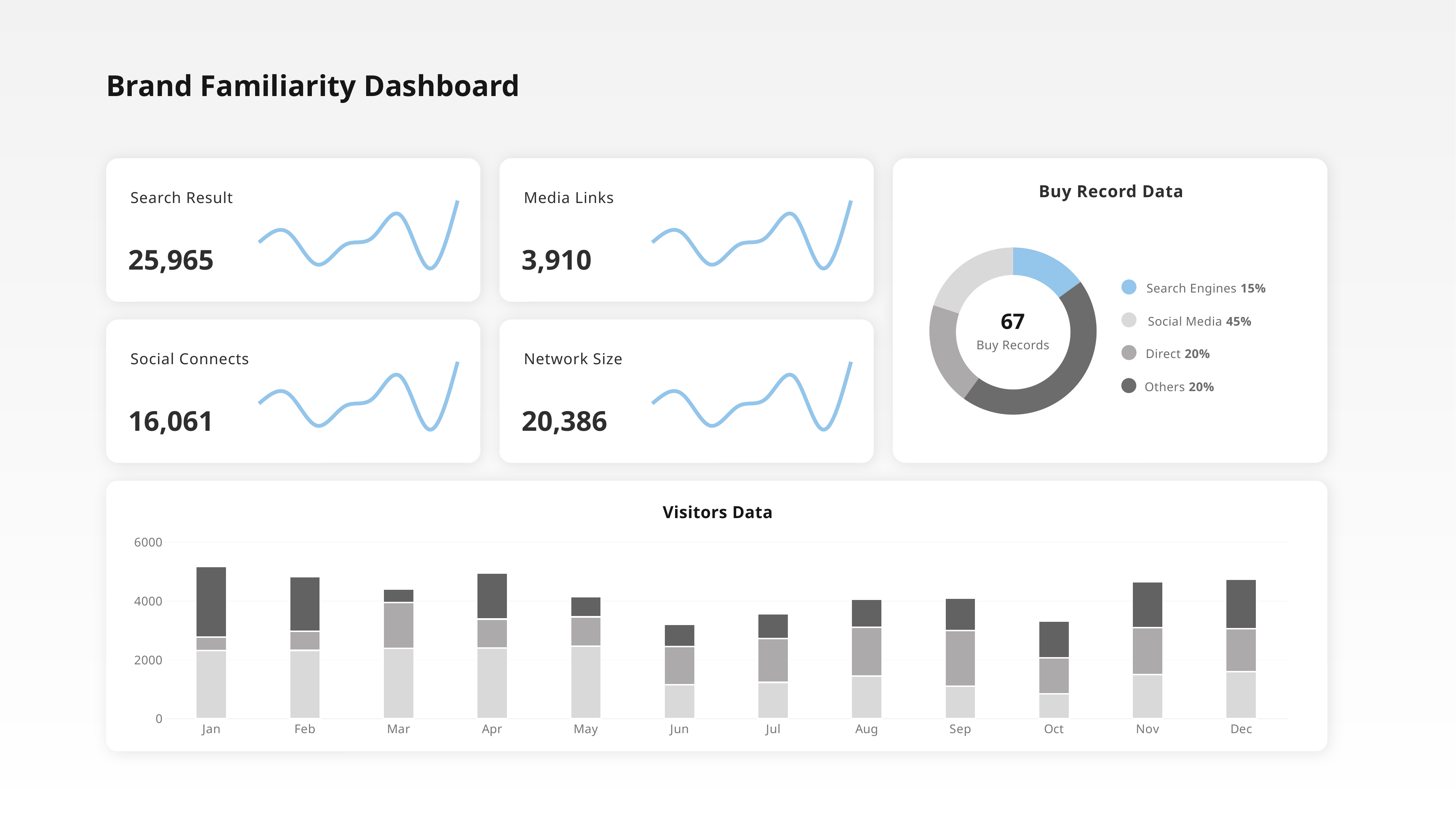
In the Visitors Data chart, how many months are shown on the x axis? 12 In the Buy Record Data chart, what percentage is Search Engines? 15% What kind of chart is the Visitors Data chart? Stacked bar chart In the Buy Record Data chart, what is the difference between the Social Media share and the Search Engines share? 30% In the Buy Record Data chart, how many categories does the legend list? 4 In the Visitors Data chart, is the total value for Jan greater or less than 4000? greater In the Buy Record Data chart, which category has the largest share? Social Media In the Buy Record Data chart, what percentage is Social Media? 45% What number is shown in the centre of the Buy Record Data chart? 67 In the Buy Record Data chart, which category has the smallest share? Search Engines In the Visitors Data chart, which month has the taller bar, Jan or Jun? Jan In the Visitors Data chart, is the total value for Jun greater or less than 4000? less